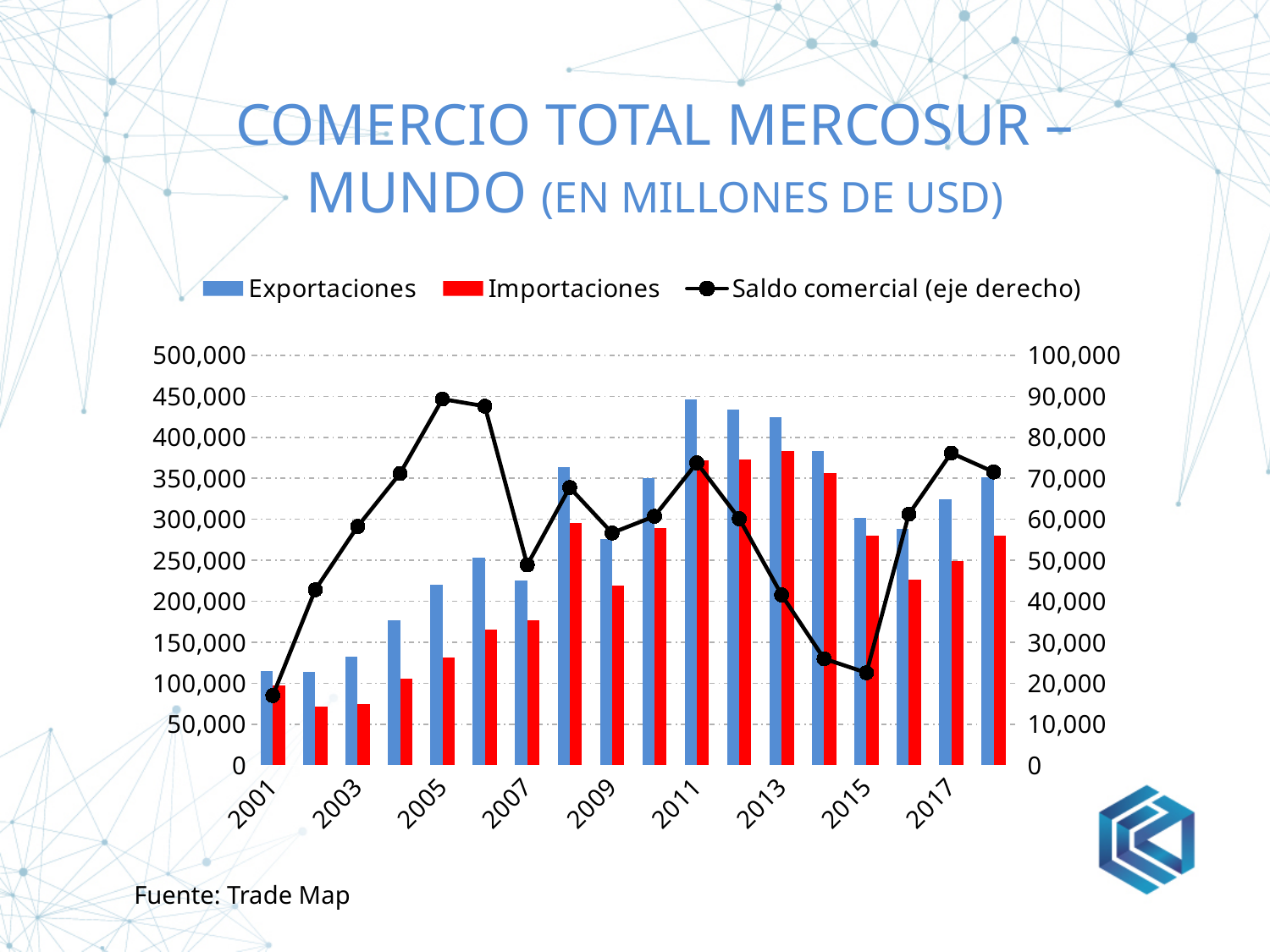
Which is larger in 2001, Exportaciones or Importaciones? Exportaciones Do the Exportaciones values rise or fall from 2001 to 2005? rise Is the value of Importaciones for 2013 greater or less than 350,000? greater Is the value of Exportaciones for 2009 greater or less than 300,000? less Which series is plotted against the right-hand axis? Saldo comercial Is the value of Saldo comercial for 2015 greater or less than 30,000? less How many years are plotted along the x axis? 18 How many series does the legend list? 3 What kind of chart is shown on the slide? A combined bar and line chart What source is cited for the chart data? Trade Map